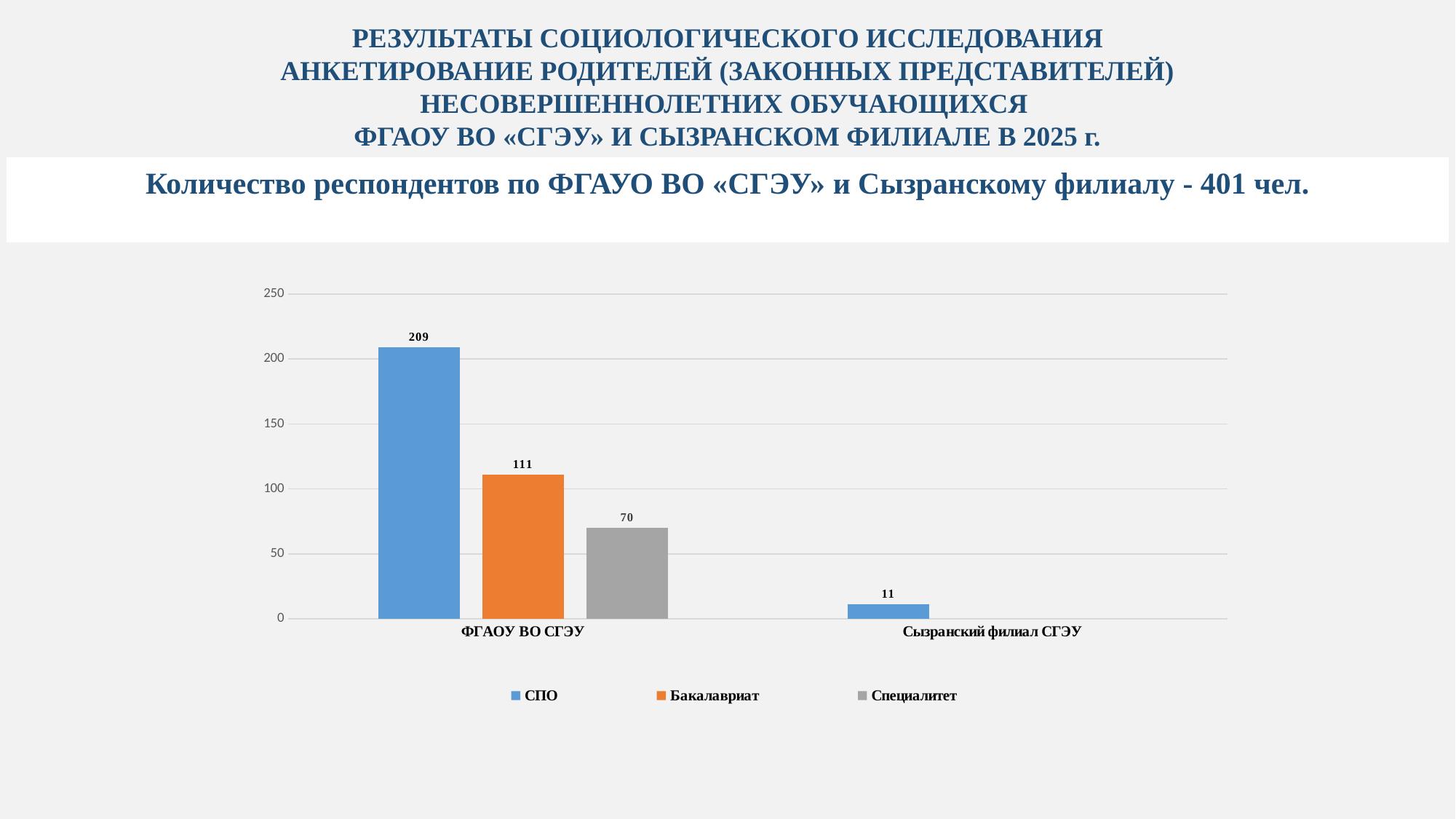
Which is larger at ФГАОУ ВО СГЭУ: Бакалавриат or Специалитет? Бакалавриат What is the difference between the СПО values for ФГАОУ ВО СГЭУ and Сызранский филиал СГЭУ? 198 What is the value for СПО at ФГАОУ ВО СГЭУ? 209 How many series does the legend list? 3 What is the value for СПО at Сызранский филиал СГЭУ? 11 Which series has the lowest value at ФГАОУ ВО СГЭУ? Специалитет Which series has the highest value at ФГАОУ ВО СГЭУ? СПО What is the difference between the СПО and Бакалавриат values at ФГАОУ ВО СГЭУ? 98 What is the value for Специалитет at ФГАОУ ВО СГЭУ? 70 What is the value for Бакалавриат at ФГАОУ ВО СГЭУ? 111 What kind of chart is shown on the slide? Bar chart How many categories are shown on the x axis? 2